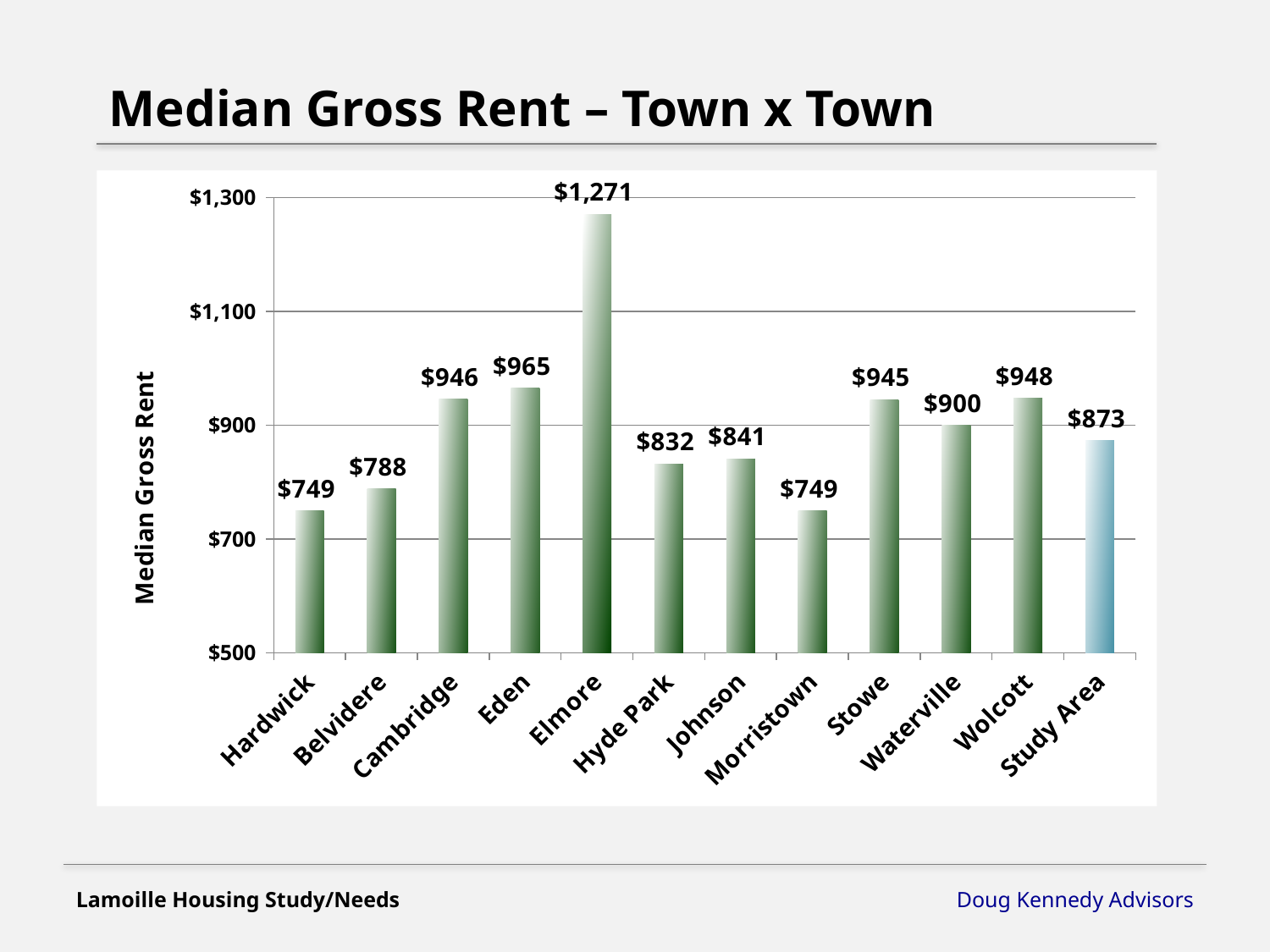
What is the median gross rent for Elmore? $1,271 Which town has the highest median gross rent? Elmore What is the median gross rent for Waterville? $900 What is the difference between the median gross rent in Johnson and in Hyde Park? $9 Is the median gross rent for Stowe greater or less than $900? greater What kind of chart is shown on the slide? Bar chart What is the difference between the median gross rent in Elmore and in Eden? $306 How many categories are shown on the x axis of the chart? 12 What is the title of the chart's vertical axis? Median Gross Rent Which has a higher median gross rent, Belvidere or Hyde Park? Hyde Park Which towns share the lowest median gross rent of $749? Hardwick and Morristown What is the median gross rent for the Study Area? $873